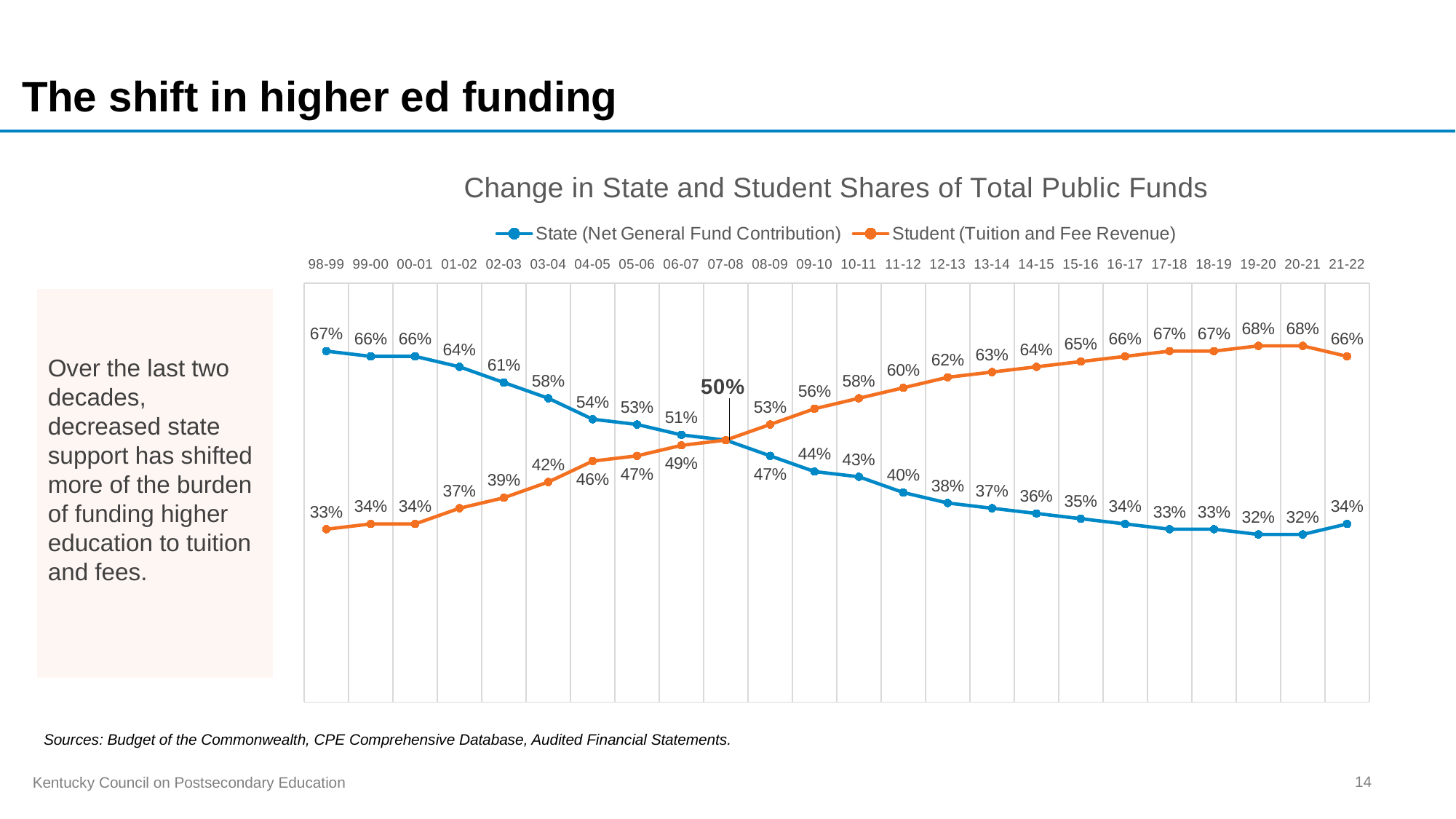
In 12-13, what is the difference between the Student share and the State share? 24 percentage points How many academic years are plotted on the x axis? 24 In which year was the Student share at its lowest? 98-99 What was the Student (Tuition and Fee Revenue) share in 21-22? 66% How many series does the legend list? 2 What kind of chart is shown on the slide? Line chart By how many percentage points did the State share fall from 98-99 to 21-22? 33 percentage points In which year do the State and Student shares both equal 50%? 07-08 In 10-11, which was larger: the State share or the Student share? Student (Tuition and Fee Revenue) Does the State (Net General Fund Contribution) share generally rise or fall from 98-99 to 21-22? Fall What was the State (Net General Fund Contribution) share in 98-99? 67% In which year was the State share at its highest? 98-99